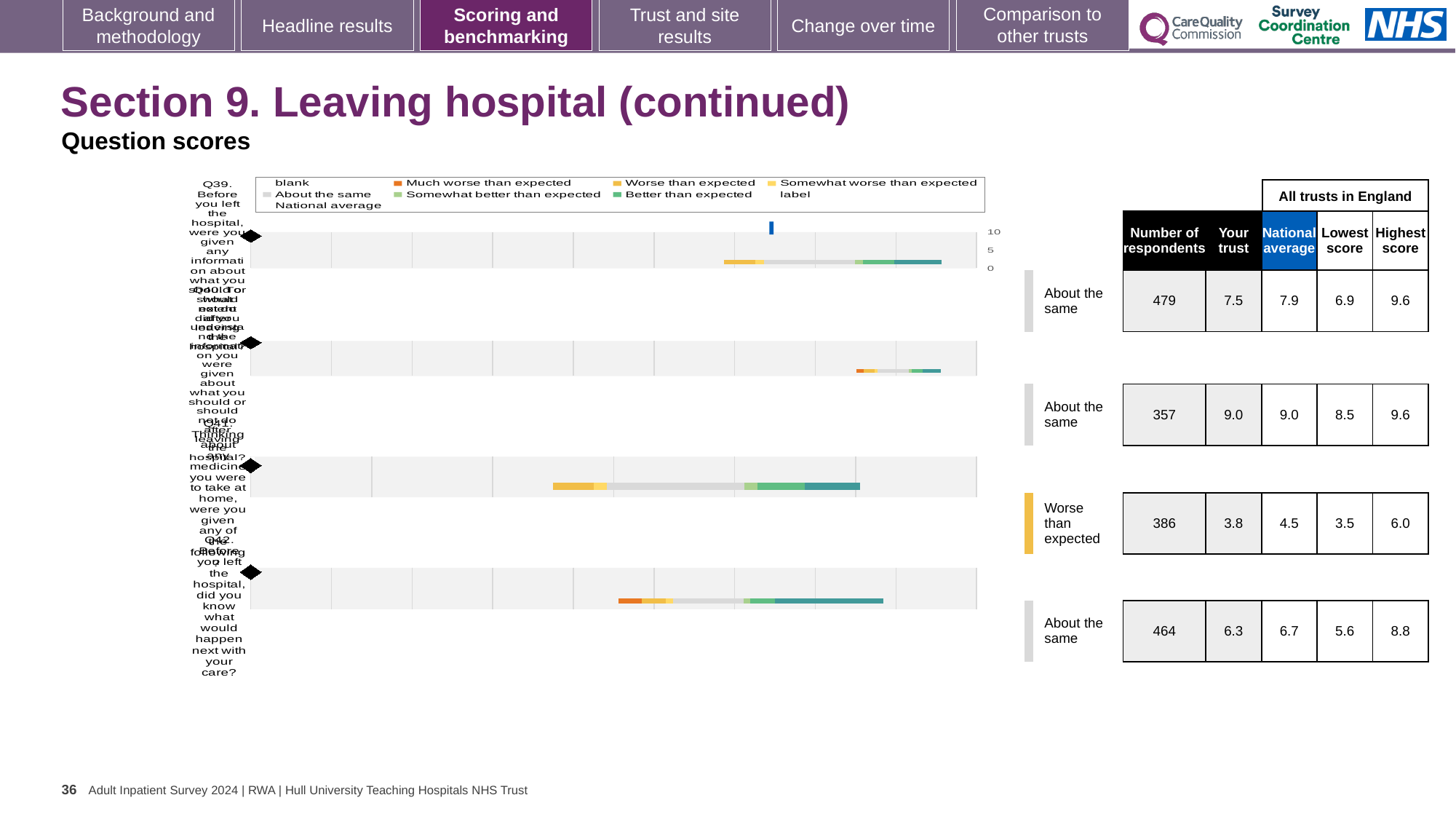
Which table row has the lowest 'Your trust' score? the third row (Q41, Worse than expected) What is the lowest score in England for the last row (Q42)? 5.6 In the table, what is the national average for the last row (Q42)? 6.7 How many question rows (bars) are plotted in the chart? 4 What benchmark category is shown for the third row (Q41)? Worse than expected In the table, what is the number of respondents for the first row (Q39)? 479 Is the trust score for the first row (Q39) larger or smaller than its national average? smaller In the table, what is the 'Your trust' score for the third row (Q41, 'Worse than expected')? 3.8 What kind of chart is shown on the slide? bar chart What is the difference between the national average and the trust score for the third row (Q41)? 0.7 Which table row has the highest number of respondents? the first row (Q39), 479 In the table, what is the highest score in England for the second row? 9.6